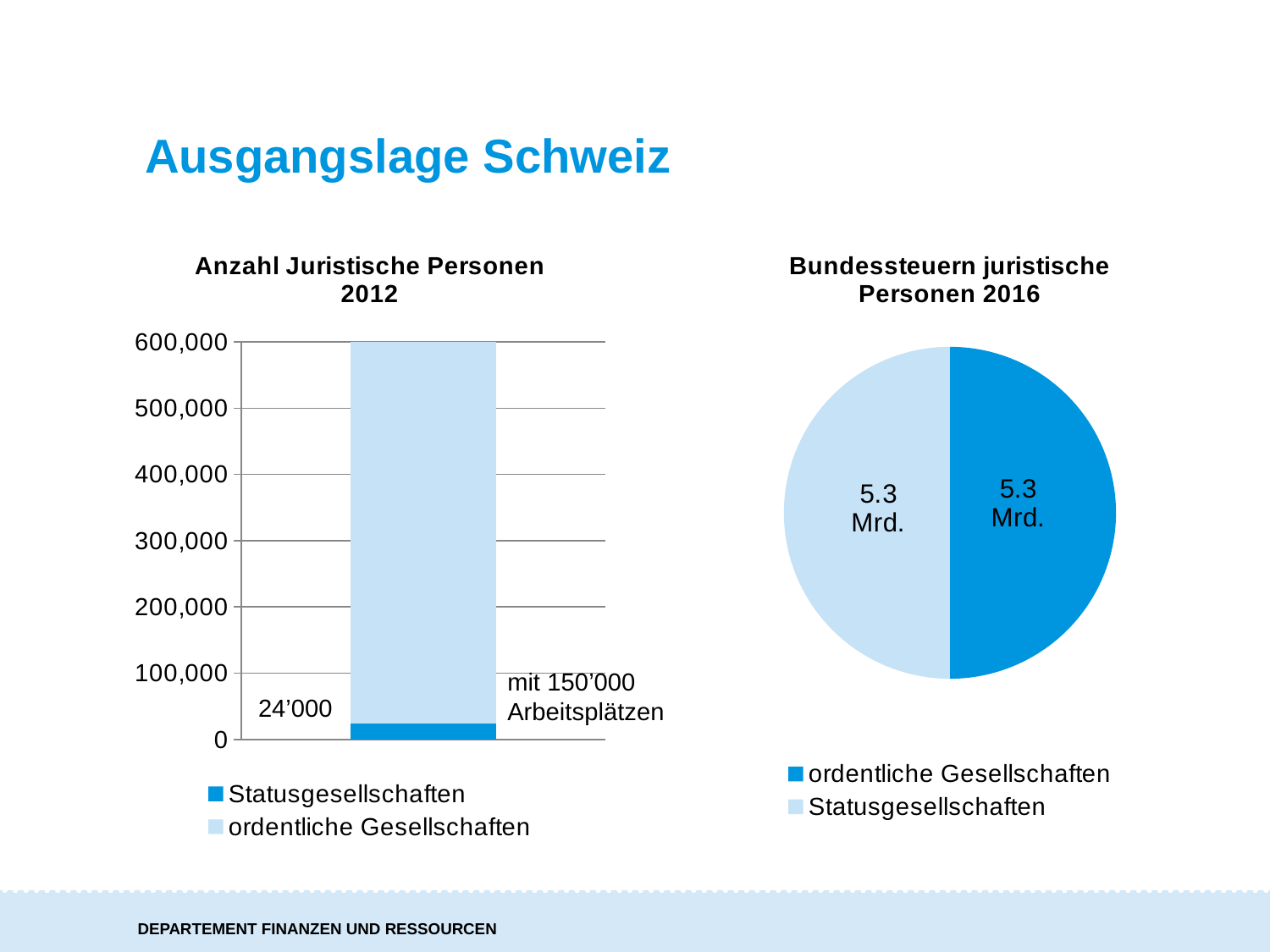
In the left chart 'Anzahl Juristische Personen 2012', what value is shown for Statusgesellschaften? 24'000 In the left chart 'Anzahl Juristische Personen 2012', what is the total height of the stacked bar? 600,000 In the right chart 'Bundessteuern juristische Personen 2016', what value is shown for ordentliche Gesellschaften? 5.3 Mrd. In the right chart 'Bundessteuern juristische Personen 2016', what value is shown for Statusgesellschaften? 5.3 Mrd. In the left chart 'Anzahl Juristische Personen 2012', what annotation is written next to the bar about Arbeitsplätze? mit 150'000 Arbeitsplätzen In the right chart 'Bundessteuern juristische Personen 2016', what share of the pie does Statusgesellschaften represent? 50% What kind of chart is the left chart, 'Anzahl Juristische Personen 2012'? bar chart In the left chart 'Anzahl Juristische Personen 2012', which series is larger, Statusgesellschaften or ordentliche Gesellschaften? ordentliche Gesellschaften How many slices does the right chart 'Bundessteuern juristische Personen 2016' have? 2 How many series does the legend of the left chart 'Anzahl Juristische Personen 2012' list? 2 In the left chart 'Anzahl Juristische Personen 2012', is the value for ordentliche Gesellschaften greater or less than 500,000? greater What kind of chart is the right chart, 'Bundessteuern juristische Personen 2016'? pie chart